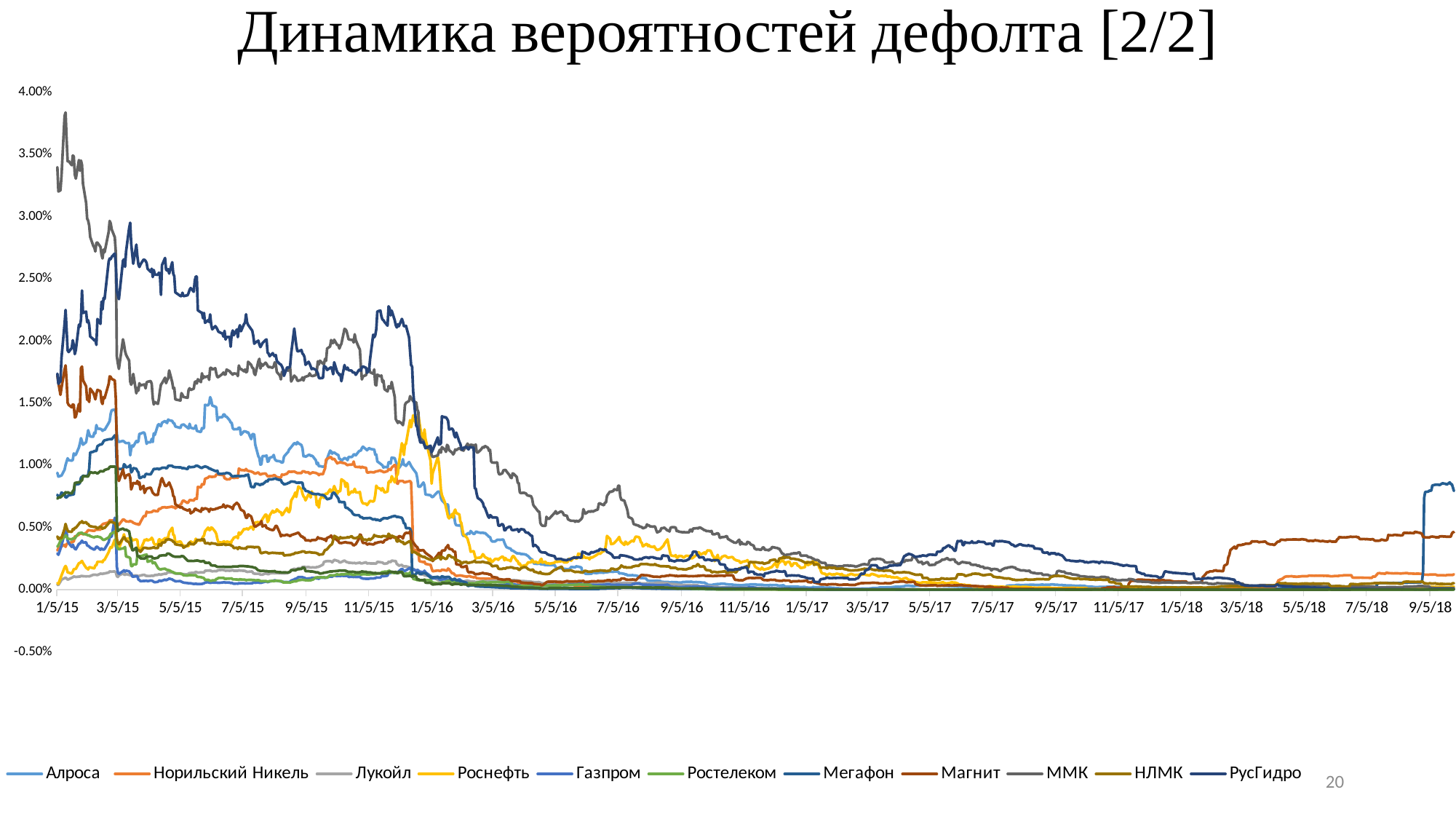
Overall, do the default probabilities rise or fall from 2015 to 2018? fall Is the highest value reached by ММК greater or less than 3.50%? greater What is the title of the chart? Динамика вероятностей дефолта [2/2] How many date labels are shown on the x axis? 23 Is the value for Роснефть around 9/5/17 greater or less than 0.50%? less Is the value for ММК at 1/5/15 greater or less than 3.00%? greater How many series does the legend list? 11 Which series is listed first in the legend? Алроса What kind of chart is shown on the slide? line chart